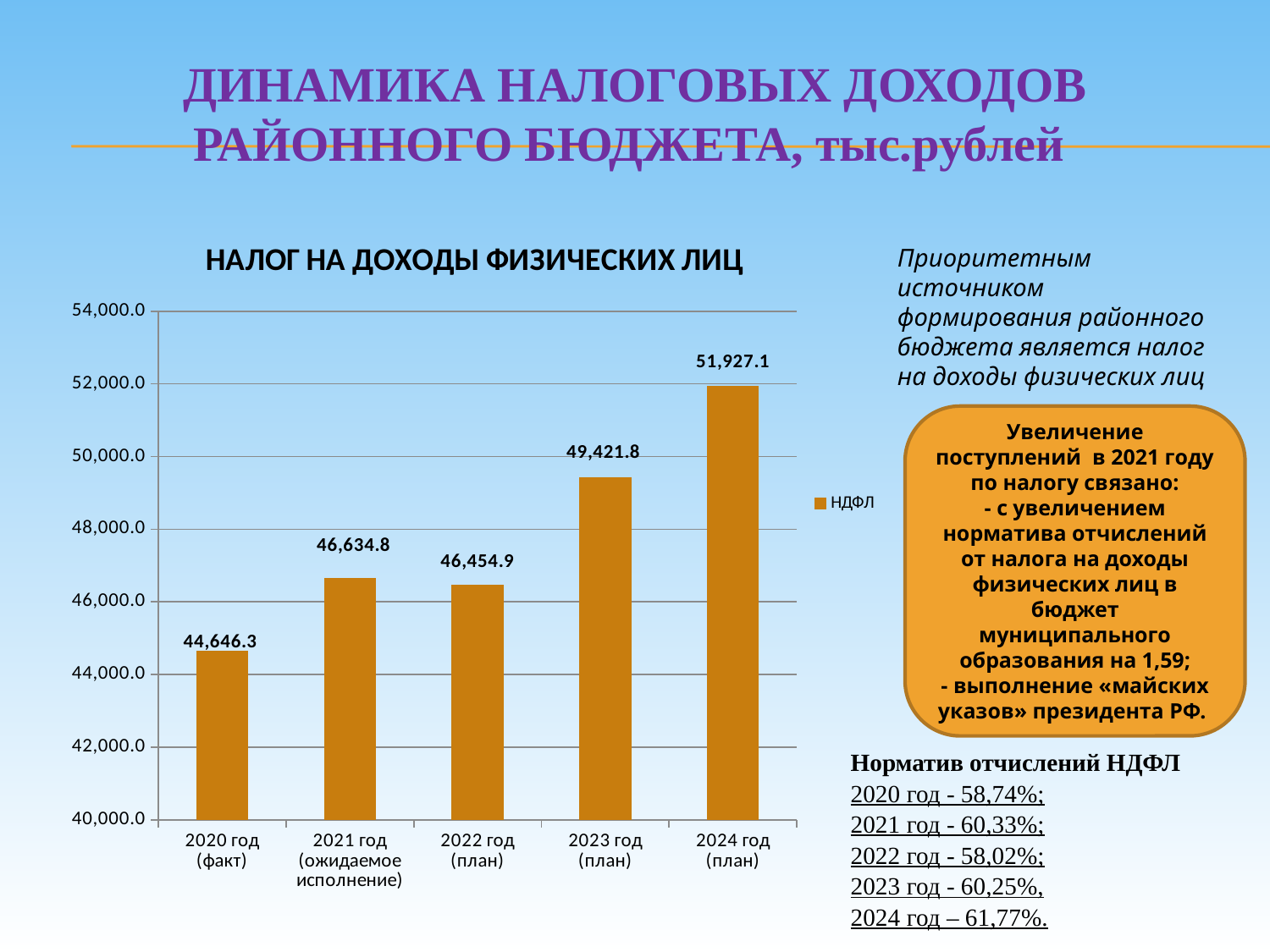
Which is larger, the value for 2021 год (ожидаемое исполнение) or 2022 год (план)? 2021 год (ожидаемое исполнение) Which year has the lowest value? 2020 год (факт) Which year has the highest value? 2024 год (план) What is the value for 2024 год (план)? 51,927.1 What series name does the legend show? НДФЛ How many years are shown on the x axis? 5 What kind of chart is shown? bar chart What is the difference between the values for 2023 год (план) and 2022 год (план)? 2,966.9 What is the difference between the values for 2024 год (план) and 2020 год (факт)? 7,280.8 What is the value for 2020 год (факт)? 44,646.3 Is the value for 2023 год (план) greater or less than 50,000.0? less What is the value for 2022 год (план)? 46,454.9